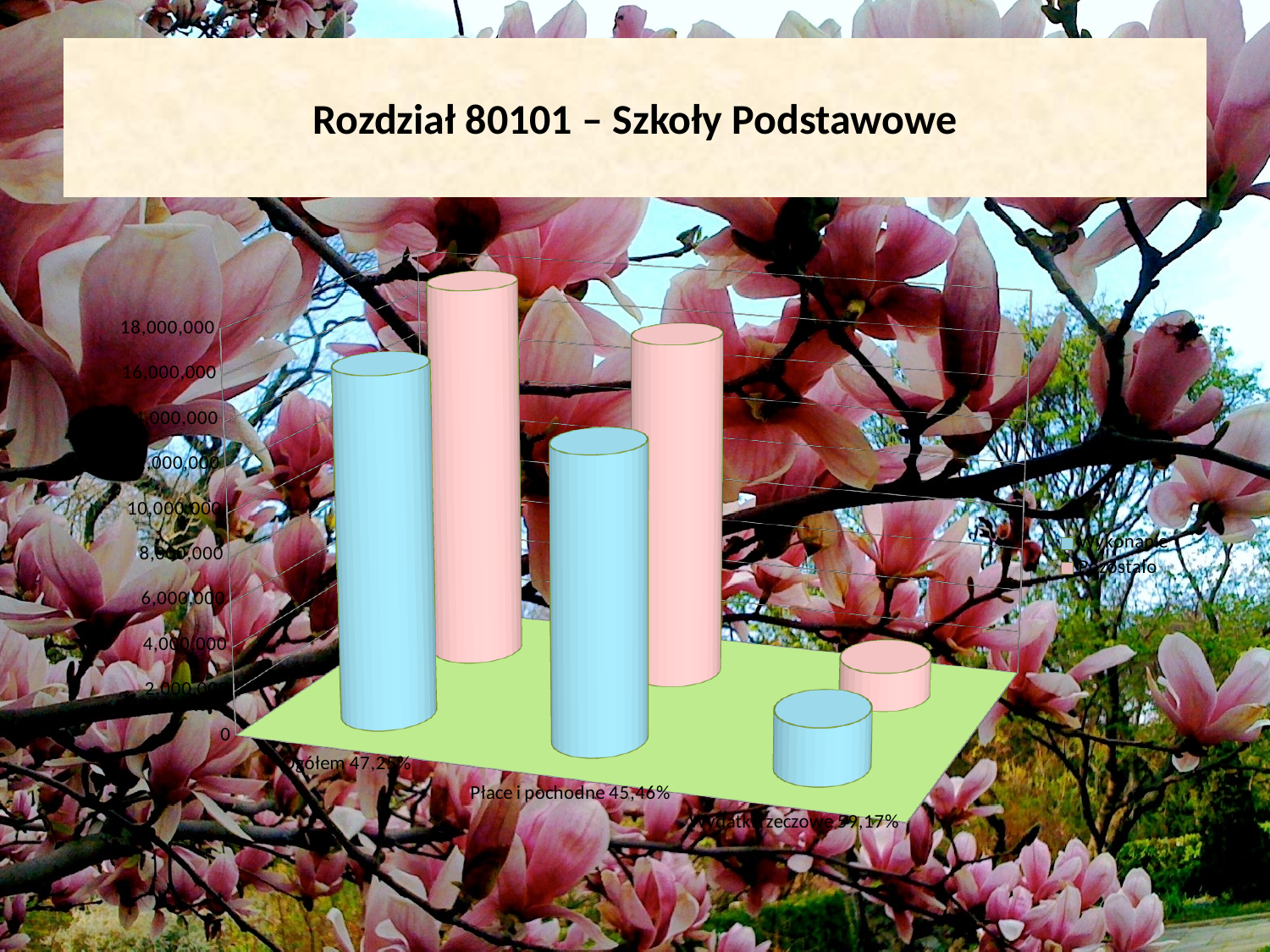
For the Ogółem category, which is larger: Wykonanie or Pozostało? Pozostało How many categories are plotted on the chart? 3 What is the title of the slide containing the chart? Rozdział 80101 – Szkoły Podstawowe Which category has the lowest value for the Wykonanie series? Wydatki rzeczowe What percentage is printed next to the Płace i pochodne category label? 45,46% What type of chart is shown on the slide? bar chart Which category has the highest value for the Pozostało series? Ogółem What are the two series named in the legend? Wykonanie and Pozostało How many series does the chart legend list? 2 Is the Wykonanie value for Płace i pochodne greater or less than 6,000,000? greater Is the Wykonanie value for Wydatki rzeczowe greater or less than 4,000,000? less Is the Pozostało value for Ogółem greater or less than 10,000,000? greater